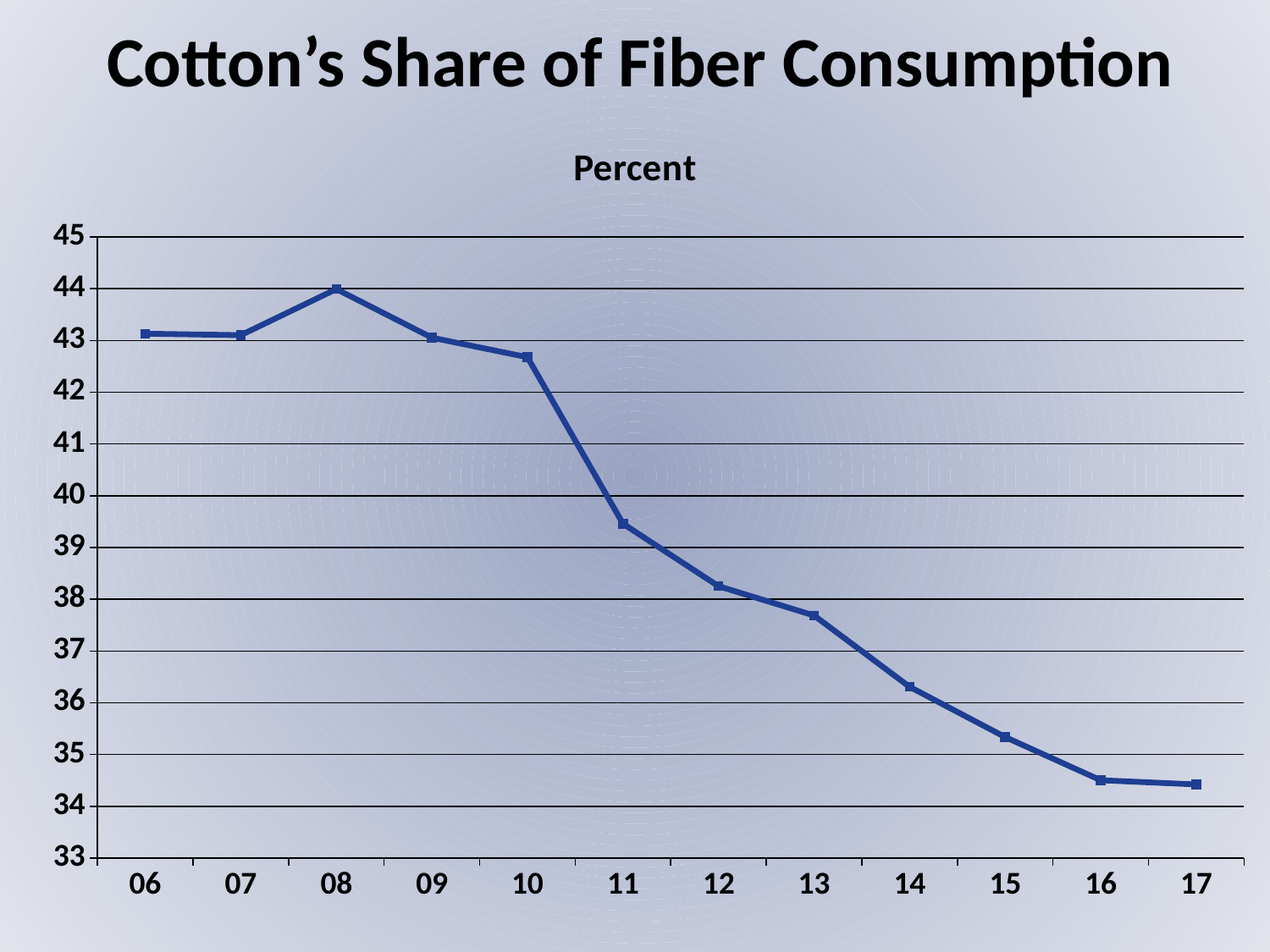
Overall, do the values rise or fall from 06 to 17? fall Is the value for 16 greater or less than 35? less What is the title of the chart? Cotton's Share of Fiber Consumption Which is larger, the value for 10 or the value for 11? 10 Is the value for 10 greater or less than 42? greater How many years are plotted on the x axis? 12 Is the value for 14 greater or less than 36? greater Which year has the highest cotton share of fiber consumption? 08 What kind of chart is shown on the slide? line chart What unit label is shown above the chart? Percent